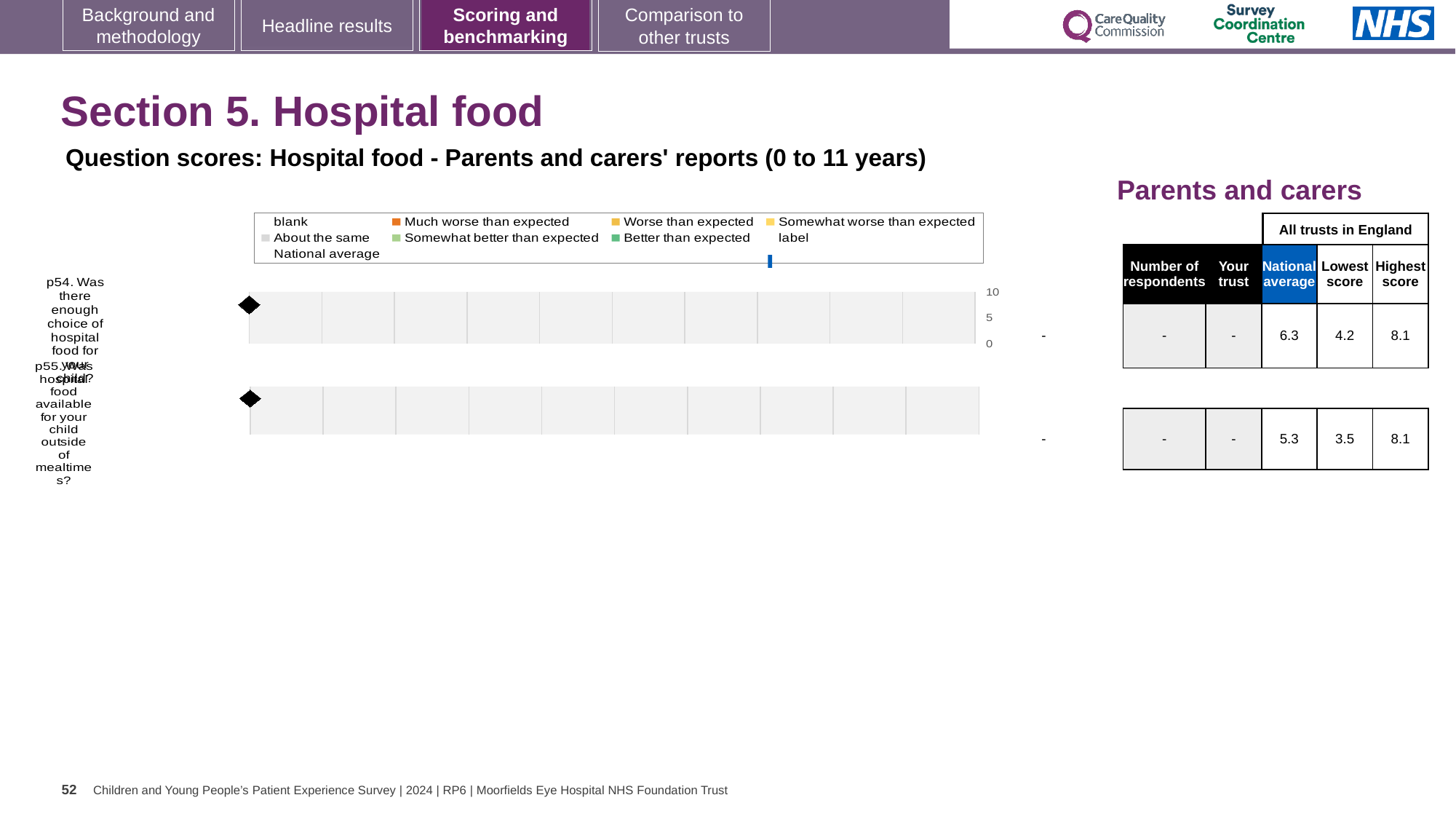
What colour does the legend use for 'Much worse than expected'? orange What kind of chart is shown on the slide? bar chart In the table beside the chart, what is the national average for p55 (food available outside of mealtimes)? 5.3 How many questions (categories) are plotted on the chart? 2 In the table beside the chart, what is the lowest score across all trusts in England for p54? 4.2 What is shown in the 'Your trust' column for p54? - How many entries does the chart legend list? 9 What is the highest value shown on the chart's score axis? 10 Which question has the higher national average, p54 or p55? p54 In the table beside the chart, what is the highest score across all trusts in England for p55? 8.1 What is the difference between the national averages for p54 and p55? 1.0 In the table beside the chart, what is the national average for p54 (enough choice of hospital food)? 6.3